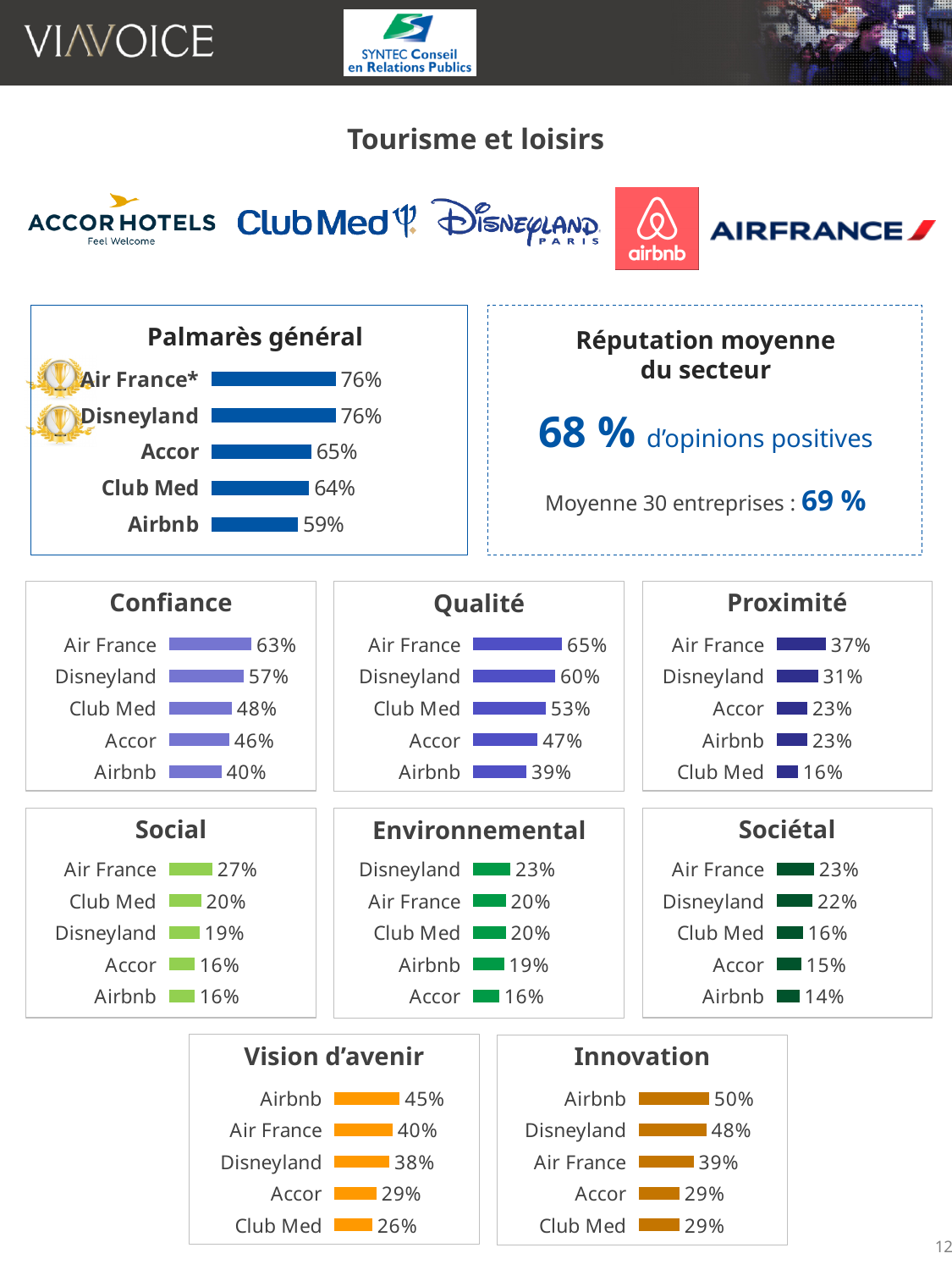
In the 'Innovation' chart, which category has the highest value? Airbnb In the 'Confiance' chart, what is the difference between Air France and Airbnb? 23% In the 'Environnemental' chart, which category has the highest value? Disneyland In the 'Proximité' chart, what is the value for Club Med? 16% What kind of chart is the 'Palmarès général' chart? Bar chart In the 'Palmarès général' chart, what is the value for Accor? 65% In the 'Qualité' chart, which category has the highest value? Air France How many categories are shown in the 'Innovation' chart? 5 In the 'Social' chart, which is larger, Club Med or Disneyland? Club Med In the 'Palmarès général' chart, which category has the lowest value? Airbnb In the 'Sociétal' chart, what is the value for Airbnb? 14% In the 'Vision d'avenir' chart, what is the difference between Airbnb and Club Med? 19%